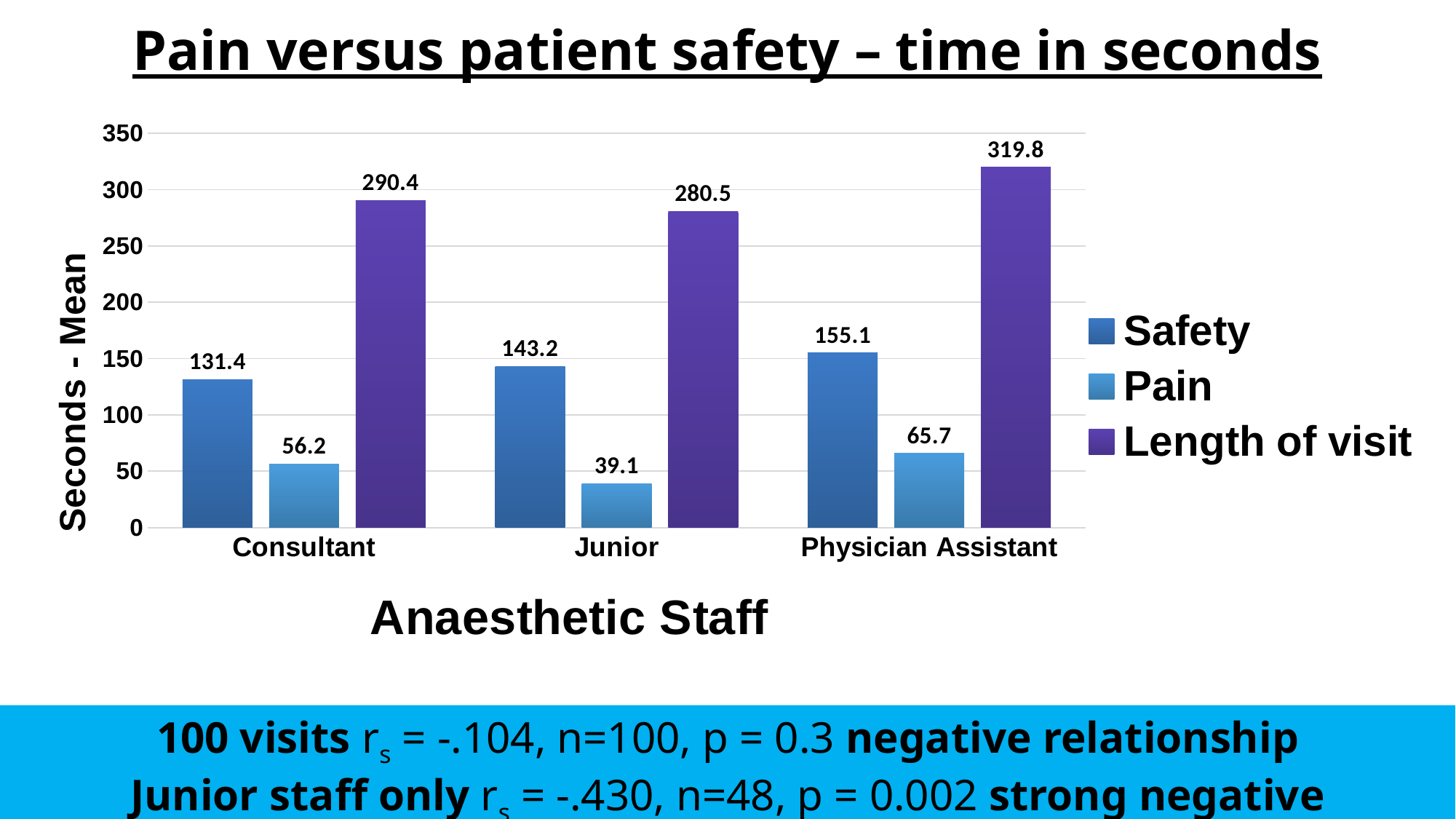
What is the label of the y axis? Seconds - Mean Which staff category has the highest Length of visit? Physician Assistant What is the Pain value for Junior? 39.1 Do the Safety values rise or fall from Consultant to Physician Assistant? Rise How many staff categories are shown on the x axis? 3 What kind of chart is shown on the slide? Bar chart What is the Safety value for Consultant? 131.4 What is the difference between the Safety and Pain values for Physician Assistant? 89.4 How many series does the legend list? 3 What is the Length of visit value for Physician Assistant? 319.8 Which is larger, the Length of visit for Consultant or for Junior? Consultant Which staff category has the lowest Pain value? Junior